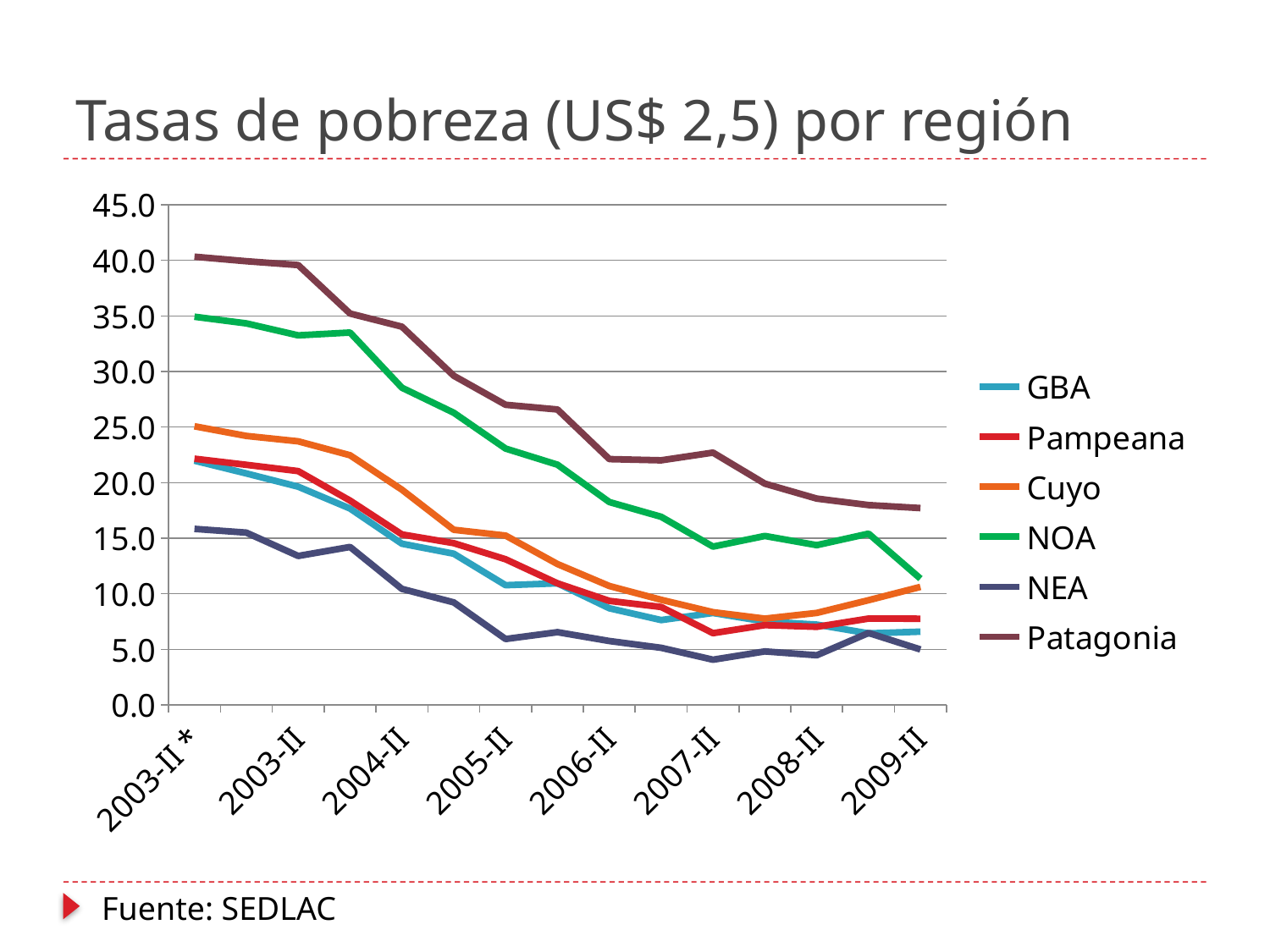
Is the value for Patagonia at 2009-II greater or less than 20? less Which is larger at 2003-II *, the value for Patagonia or the value for NOA? Patagonia Is the value for Patagonia at 2007-II greater or less than 20? greater Which region has the lowest poverty rate at 2003-II *? NEA Which region has the highest poverty rate at 2009-II? Patagonia What kind of chart is shown on the slide? line chart Is the value for NOA at 2009-II greater or less than 10? greater How many series does the legend list? 6 What is the title of the chart? Tasas de pobreza (US$ 2,5) por región Which region has the highest poverty rate at 2003-II *? Patagonia Does the Patagonia line rise or fall from 2003-II * to 2009-II? fall